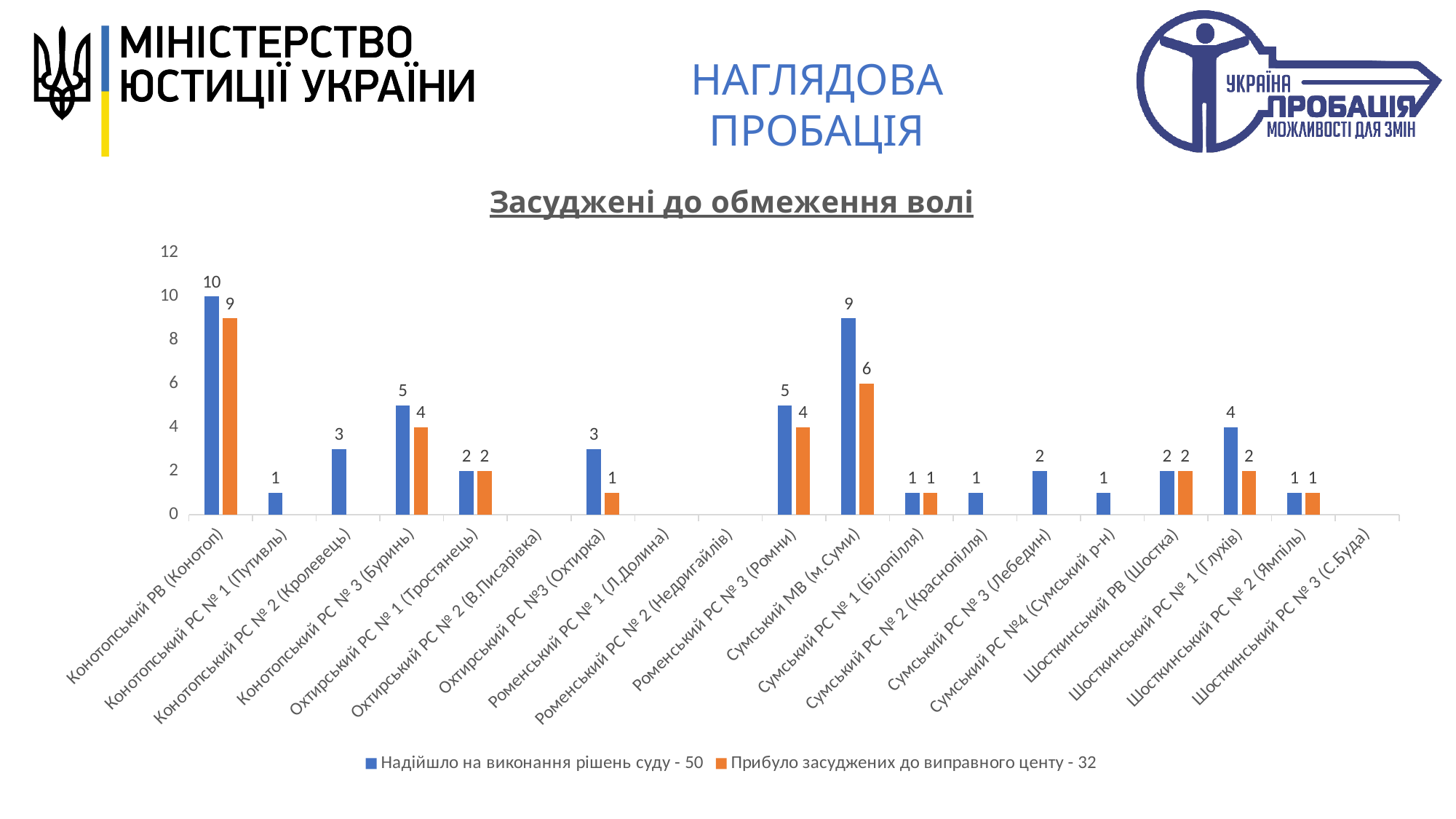
What type of chart is shown on the slide? bar chart What is the difference between the two series for Сумський МВ (м.Суми)? 3 What is the title of the chart? Засуджені до обмеження волі What is the value of 'Надійшло на виконання рішень суду' for Конотопський РВ (Конотоп)? 10 What is the value of 'Прибуло засуджених до виправного центу' for Охтирський РС №3 (Охтирка)? 1 What is the value of 'Надійшло на виконання рішень суду' for Шосткинський РС № 1 (Глухів)? 4 What is the value of 'Прибуло засуджених до виправного центу' for Сумський МВ (м.Суми)? 6 How many categories are shown on the x axis? 19 How many series does the legend list? 2 Which is larger: 'Надійшло на виконання рішень суду' for Роменський РС № 3 (Ромни) or for Охтирський РС №3 (Охтирка)? Роменський РС № 3 (Ромни) Which category has the highest value for 'Надійшло на виконання рішень суду'? Конотопський РВ (Конотоп) What is the difference between 'Надійшло на виконання рішень суду' for Конотопський РВ (Конотоп) and for Сумський МВ (м.Суми)? 1